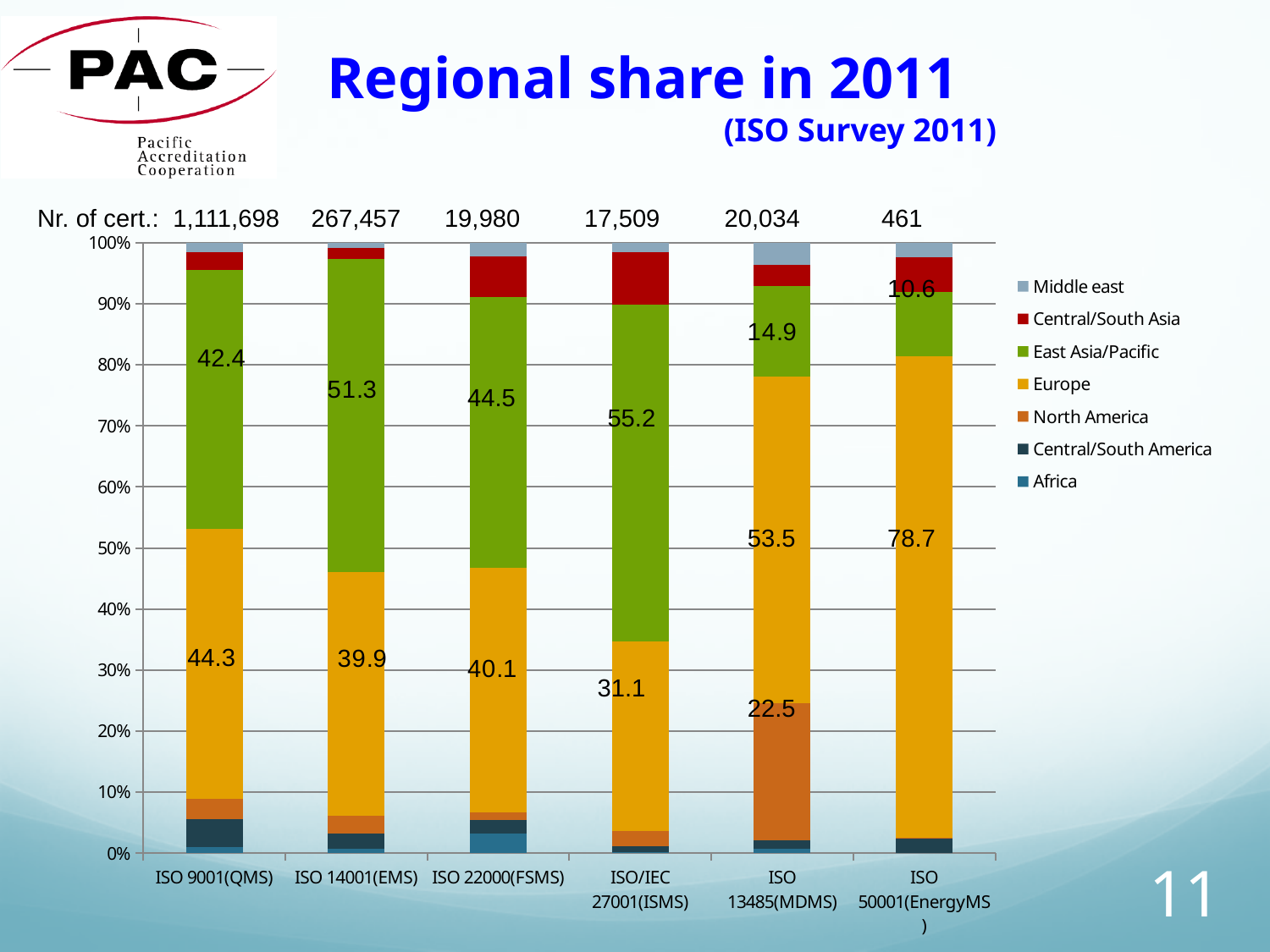
What type of chart is shown on the slide? stacked bar chart Which standard has the lowest labelled East Asia/Pacific share? ISO 50001(EnergyMS) How many ISO standards (categories) are shown on the x axis? 6 What is the difference between the Europe share for ISO 13485(MDMS) and the Europe share for ISO 9001(QMS)? 9.2 What is the number of certificates shown for ISO 9001(QMS)? 1,111,698 Which is larger for ISO 14001(EMS): the Europe share or the East Asia/Pacific share? East Asia/Pacific Which series is shown in orange in the legend? North America What is the Europe share for ISO 50001(EnergyMS)? 78.7 How many series does the legend list? 7 What is the North America share for ISO 13485(MDMS)? 22.5 Which standard has the highest labelled Europe share? ISO 50001(EnergyMS) What is the East Asia/Pacific share for ISO/IEC 27001(ISMS)? 55.2